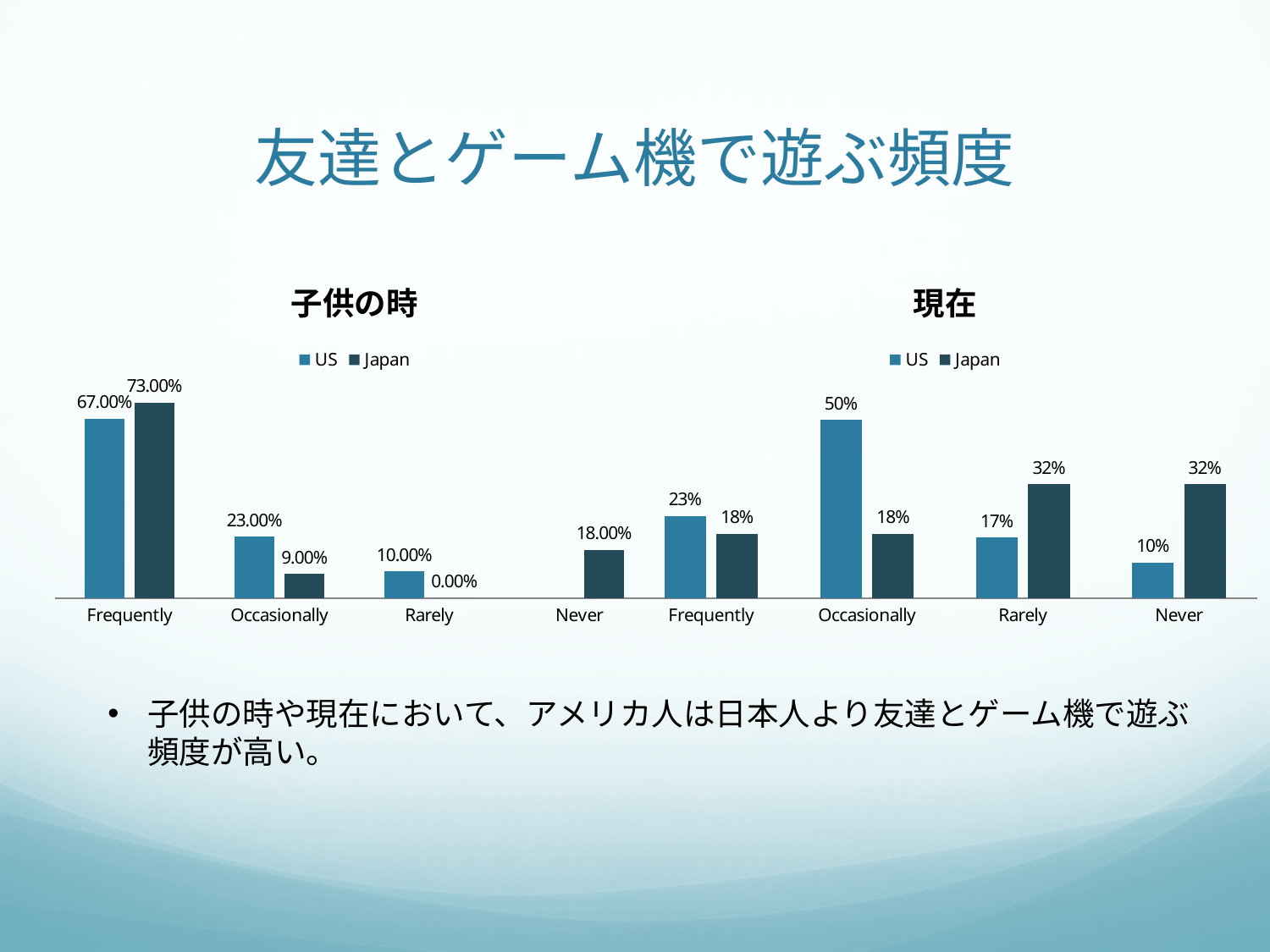
How many series does the legend of the 現在 chart list? 2 In the 現在 chart, what is the value for US in the Occasionally category? 50% In the 子供の時 chart, which category has the highest value for Japan? Frequently In the 子供の時 chart, what is the value for Japan in the Occasionally category? 9.00% In the 現在 chart, what is the difference between the US and Japan values for Occasionally? 32% In the 現在 chart, which category has the lowest value for US? Never In the 子供の時 chart, what is the value for US in the Frequently category? 67.00% In the 子供の時 chart, what is the difference between the Japan and US values for Frequently? 6.00% What kind of chart is the 子供の時 chart? Bar chart In the 子供の時 chart, what is the value for Japan in the Never category? 18.00% In the 現在 chart, which is larger for Frequently, the US value or the Japan value? US In the 現在 chart, what is the value for Japan in the Rarely category? 32%